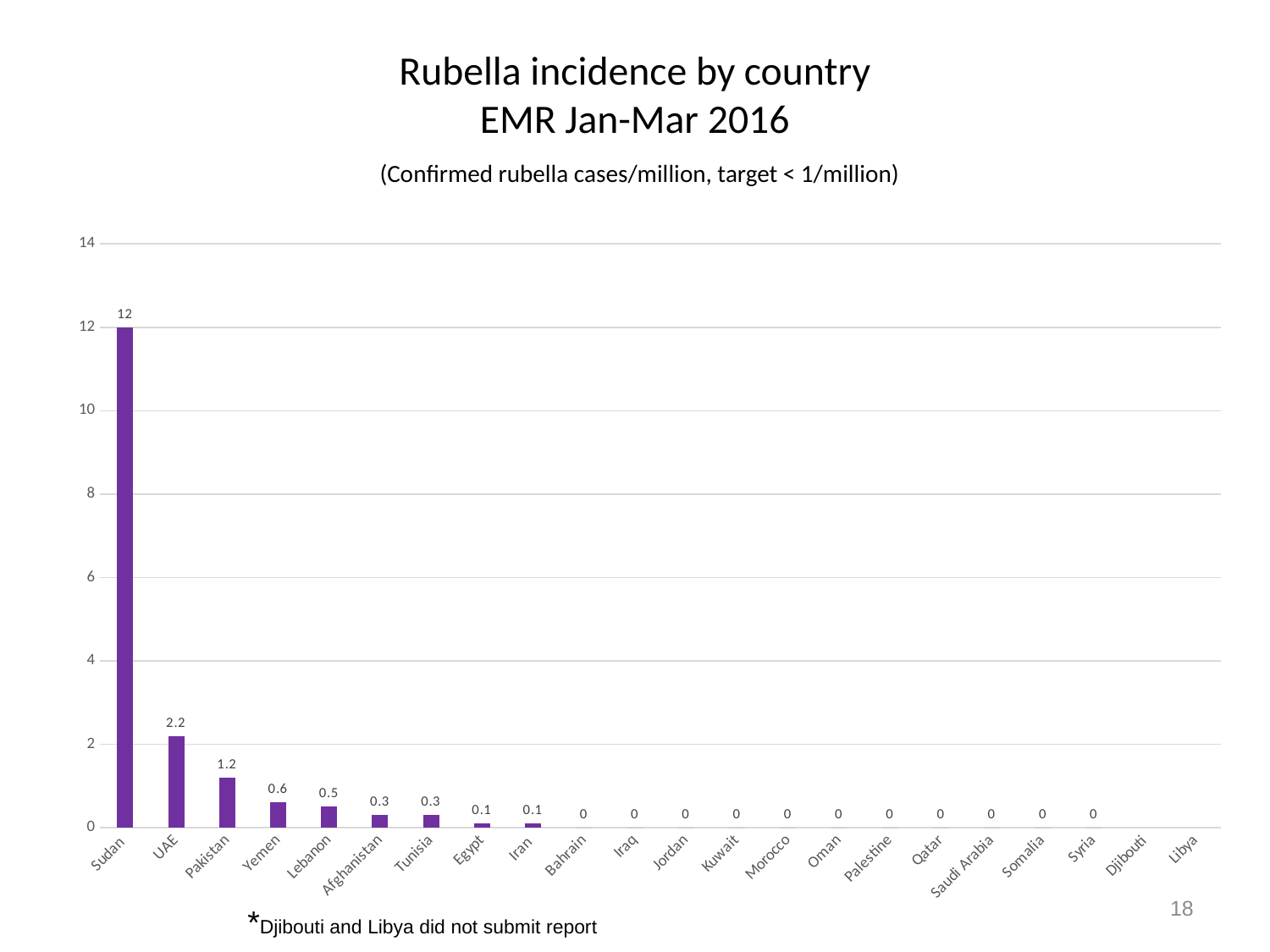
How many countries are listed on the x axis of the chart? 22 What is the rubella incidence value for UAE? 2.2 Which country has the highest rubella incidence on the chart? Sudan What is the rubella incidence value for Sudan? 12 Is the value for Sudan greater or less than 10? greater What is the rubella incidence value for Pakistan? 1.2 What is the rubella incidence value for Yemen? 0.6 What is the difference between the values for Sudan and UAE? 9.8 Which two countries did not submit a report, according to the footnote? Djibouti and Libya What kind of chart is shown on the slide? Bar chart Which has a larger value, Yemen or Lebanon? Yemen What is the difference between the values for Pakistan and Lebanon? 0.7